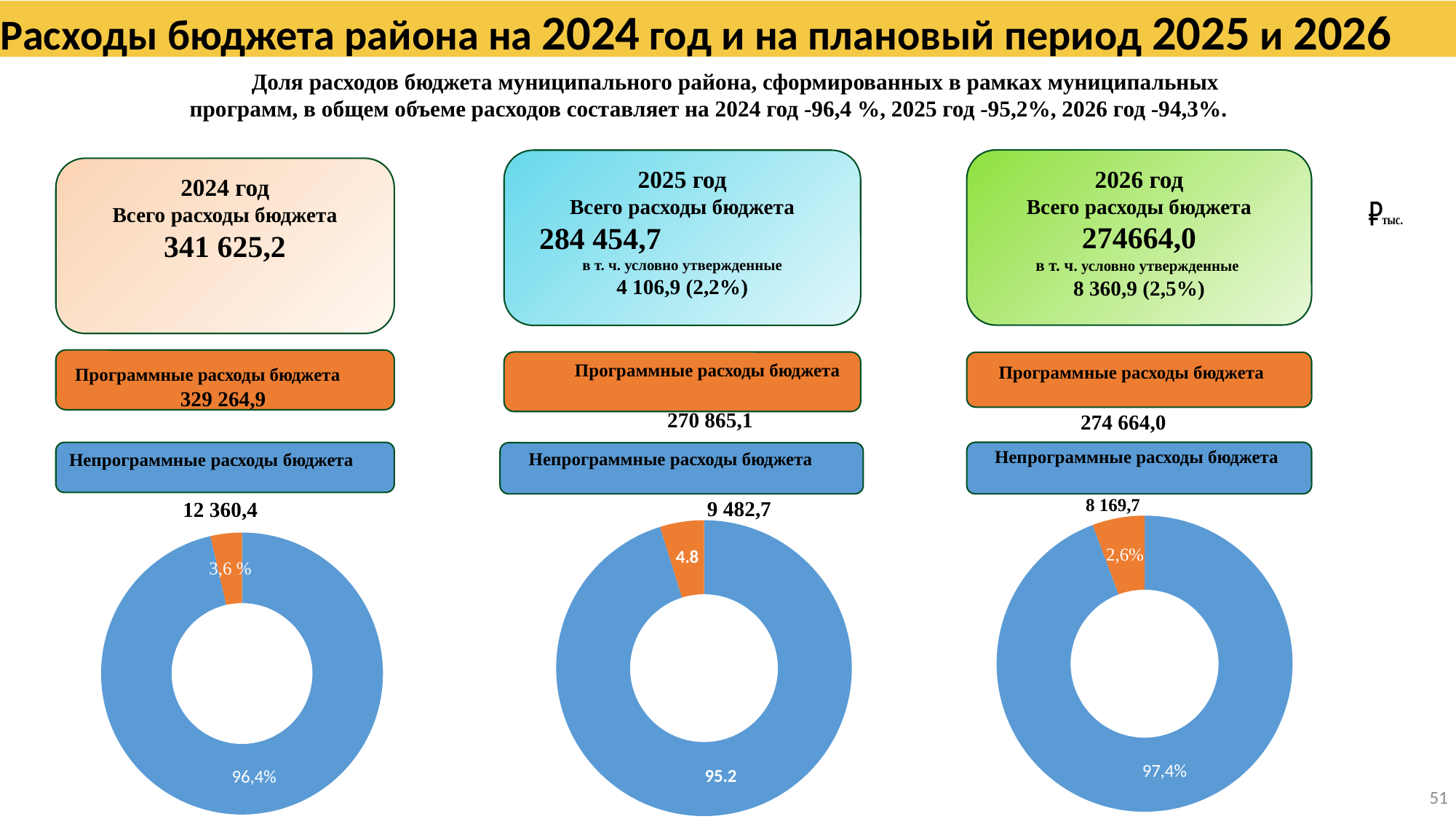
What kind of chart is used for the 2024 год chart at the bottom left of the slide? Doughnut (pie) chart In the 2024 год doughnut chart, which slice is larger, the blue one or the orange one? The blue one In the 2025 год doughnut chart, what value is printed on the blue slice? 95.2 In the 2026 год doughnut chart, what share is shown for the orange slice? 2,6% In the 2026 год doughnut chart, what share is shown for the blue slice? 97,4% How many slices does each doughnut chart on the slide contain? 2 How many doughnut charts are shown on the slide? 3